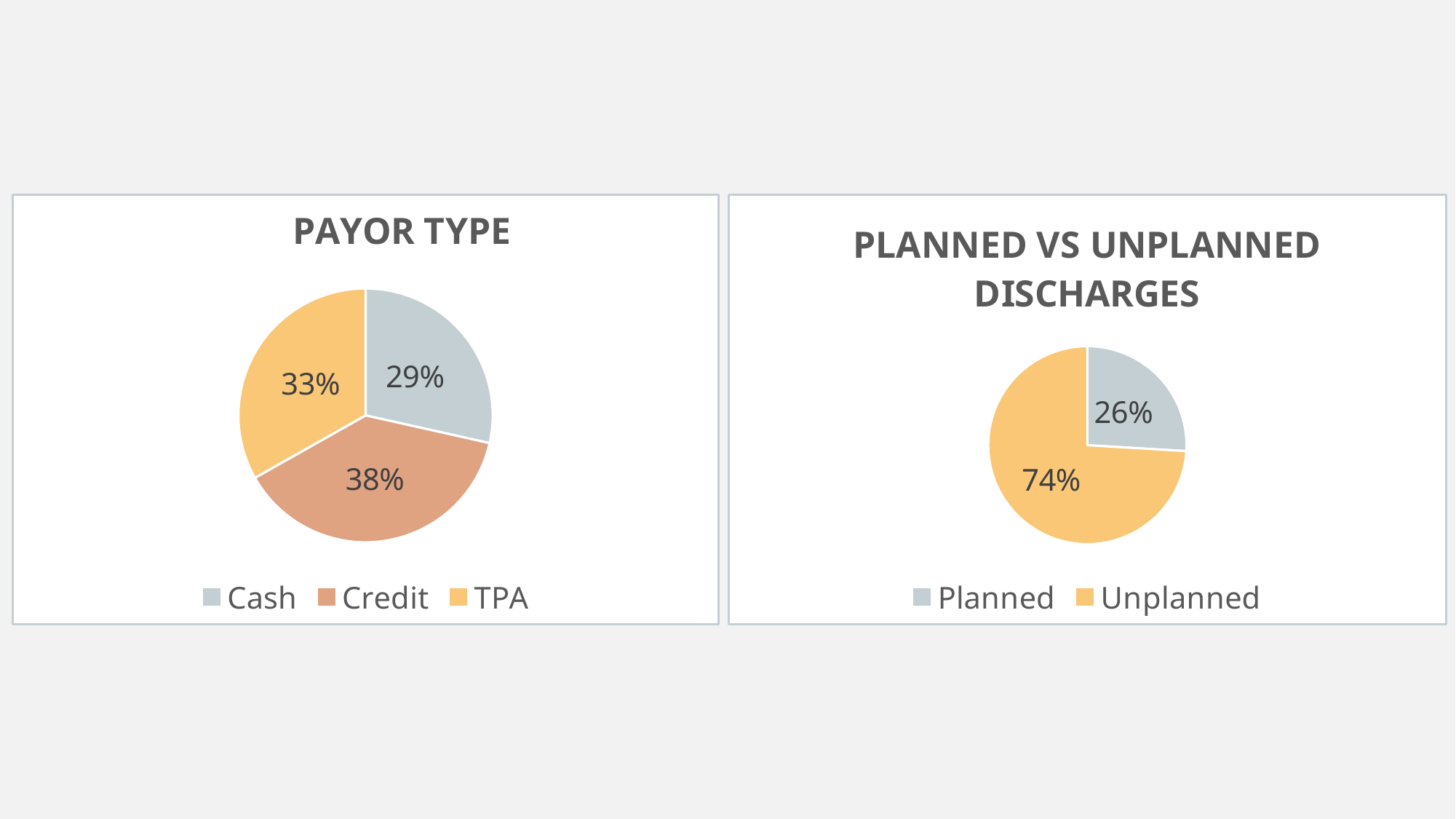
In the PAYOR TYPE chart, what share does TPA have? 33% In the PAYOR TYPE chart, what share does Credit have? 38% What kind of chart is the PAYOR TYPE chart? Pie chart In the PAYOR TYPE chart, how many categories are shown? 3 In the PAYOR TYPE chart, which payor type has the largest share? Credit In the PLANNED VS UNPLANNED DISCHARGES chart, what colour represents Unplanned? Yellow/orange In the PLANNED VS UNPLANNED DISCHARGES chart, which is larger, Planned or Unplanned? Unplanned In the PLANNED VS UNPLANNED DISCHARGES chart, what share is Unplanned? 74% In the PAYOR TYPE chart, which payor type has the smallest share? Cash In the PAYOR TYPE chart, what is the difference in percentage points between Credit and Cash? 9 percentage points